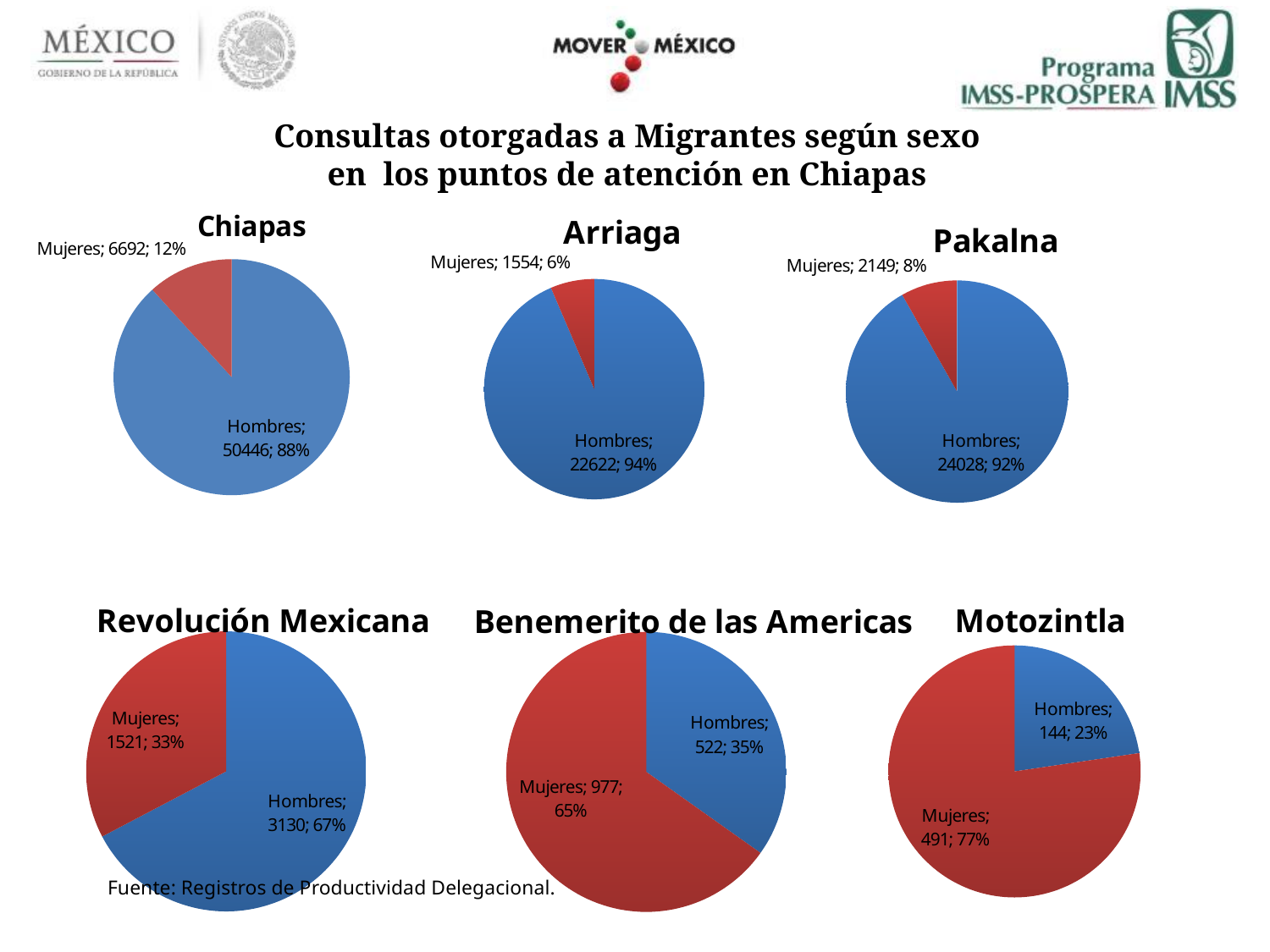
In the Benemerito de las Americas pie chart, what share of the pie is Mujeres? 65% In the Revolución Mexicana pie chart, which category is larger, Hombres or Mujeres? Hombres In the Pakalna pie chart, what is the value for Hombres? 24028 What type of chart is used for each of the six charts on the slide? Pie chart In the Motozintla pie chart, which category is the smallest? Hombres In the Arriaga pie chart, what percentage of the pie is Hombres? 94% In the Revolución Mexicana pie chart, what is the total of the two slices? 4651 In the Chiapas pie chart, what share of the pie is Mujeres? 12% In the Arriaga pie chart, what is the value for Mujeres? 1554 In the Pakalna pie chart, what is the difference between the Hombres and Mujeres values? 21879 In the Chiapas pie chart, how many consultations were given to Hombres? 50446 In the Motozintla pie chart, what is the value for Mujeres? 491